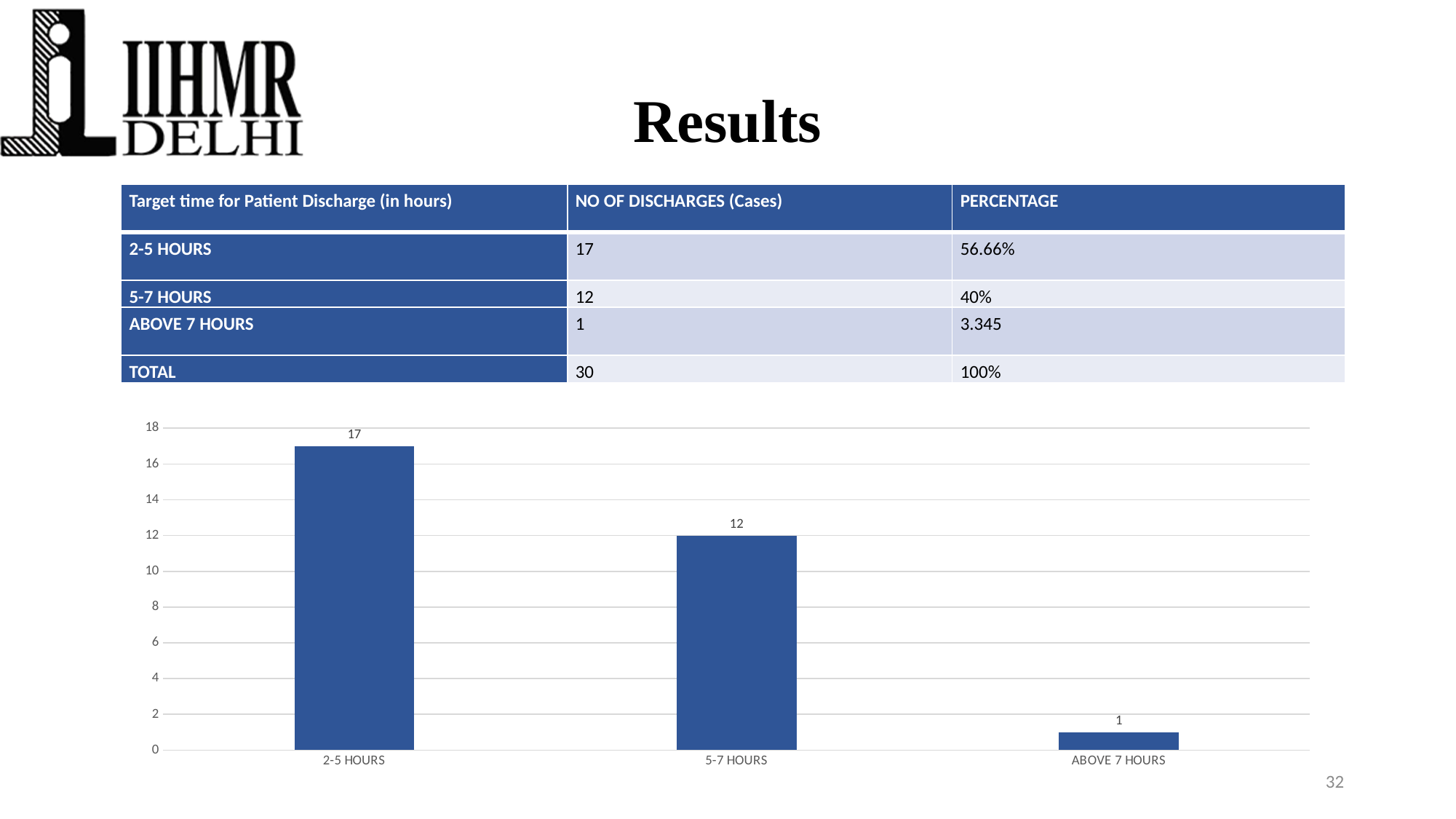
What is the value for 2-5 HOURS in the bar chart? 17 Is the value for 5-7 HOURS in the bar chart greater or less than 10? greater What is the value for ABOVE 7 HOURS in the bar chart? 1 Which category has the lowest value in the bar chart? ABOVE 7 HOURS Do the values in the bar chart rise or fall from left to right along the x axis? fall What is the value for 5-7 HOURS in the bar chart? 12 Which is larger in the bar chart, the value for 2-5 HOURS or the value for 5-7 HOURS? 2-5 HOURS What is the difference between the values for 5-7 HOURS and ABOVE 7 HOURS in the bar chart? 11 Which category has the highest value in the bar chart? 2-5 HOURS How many categories are shown in the bar chart? 3 What is the difference between the values for 2-5 HOURS and 5-7 HOURS in the bar chart? 5 What kind of chart is shown on the slide? bar chart